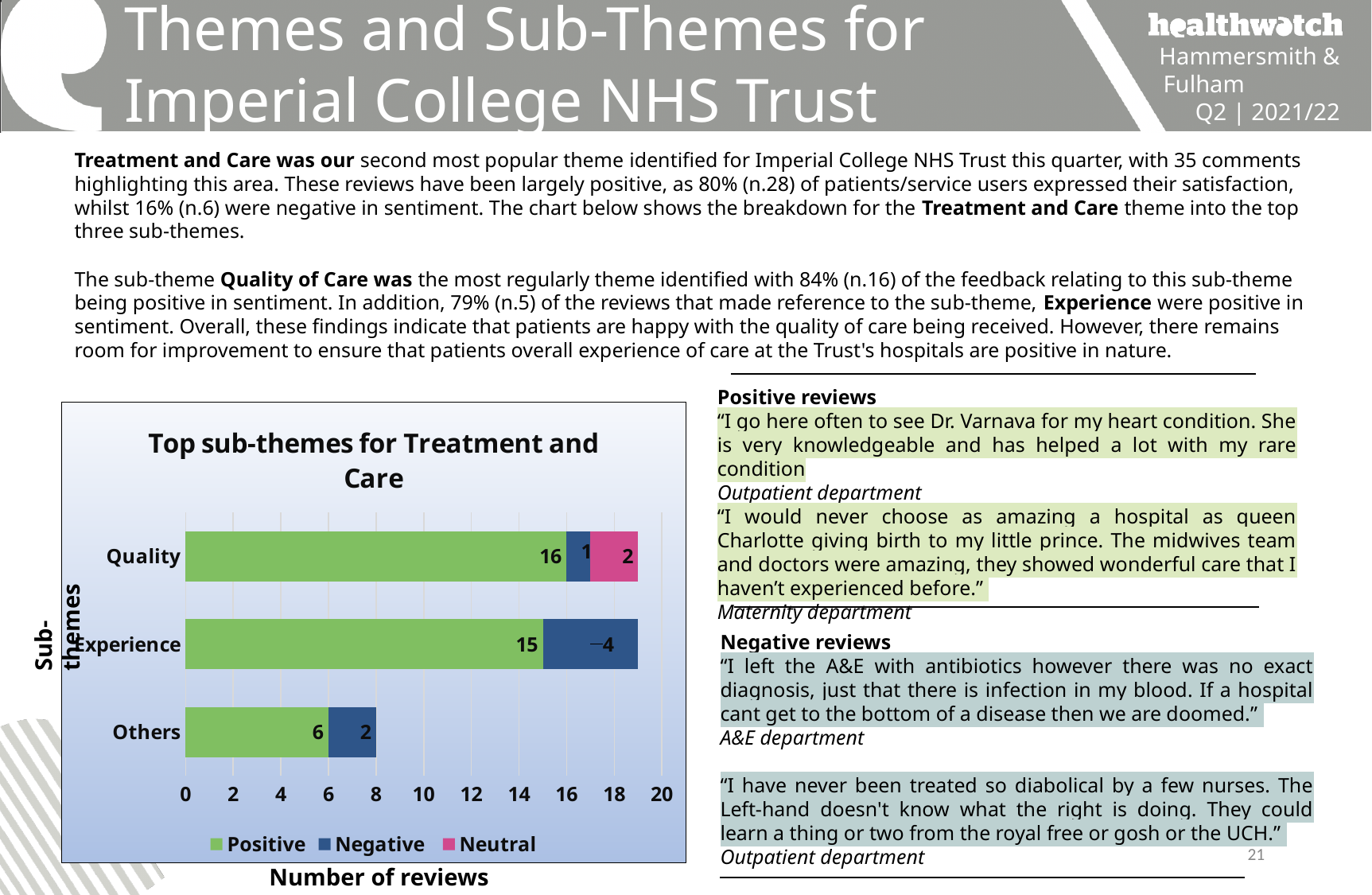
Which sub-theme has the lowest total number of reviews? Others How many series does the chart legend list? 3 What is the difference between the Positive reviews for Quality and the Positive reviews for Experience? 1 What is the title of the chart? Top sub-themes for Treatment and Care Which sub-theme has the highest number of Positive reviews? Quality What is the total number of reviews for the Others sub-theme? 8 How many sub-theme categories are plotted on the chart? 3 What kind of chart is shown on the slide? Stacked bar chart What is the number of Negative reviews for the Experience sub-theme? 4 What is the number of Positive reviews for Others? 6 What is the number of Positive reviews for the Quality sub-theme? 16 What is the number of Neutral reviews for the Quality sub-theme? 2